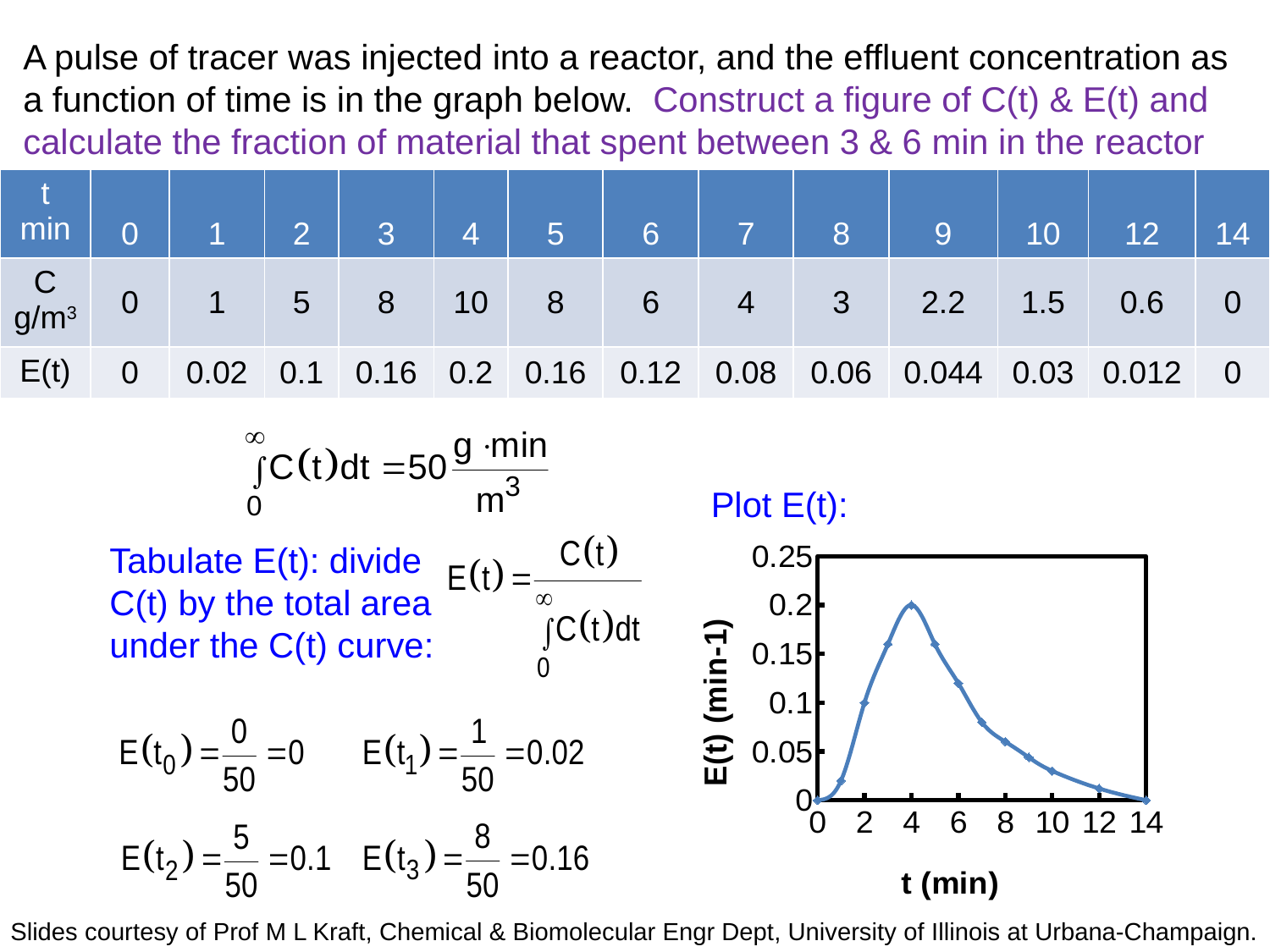
Does E(t) rise or fall as t increases from 4 min to 14 min? fall What is the difference between E(t) at t = 4 min and E(t) at t = 2 min? 0.1 What is the value of E(t) at t = 2 min in the plot? 0.1 What is the value of E(t) at t = 14 min in the plot? 0 Which is larger, E(t) at t = 3 min or E(t) at t = 7 min? t = 3 min What is the label on the x axis of the E(t) plot? t (min) What kind of chart is the E(t) plot on the slide? line chart Is the value of E(t) at t = 6 min greater or less than 0.1? greater At which value of t (min) does E(t) reach its highest value in the plot? 4 How many data points are plotted on the E(t) curve? 13 What is the value of E(t) at t = 4 min in the plot? 0.2 Is the value of E(t) at t = 10 min greater or less than 0.05? less